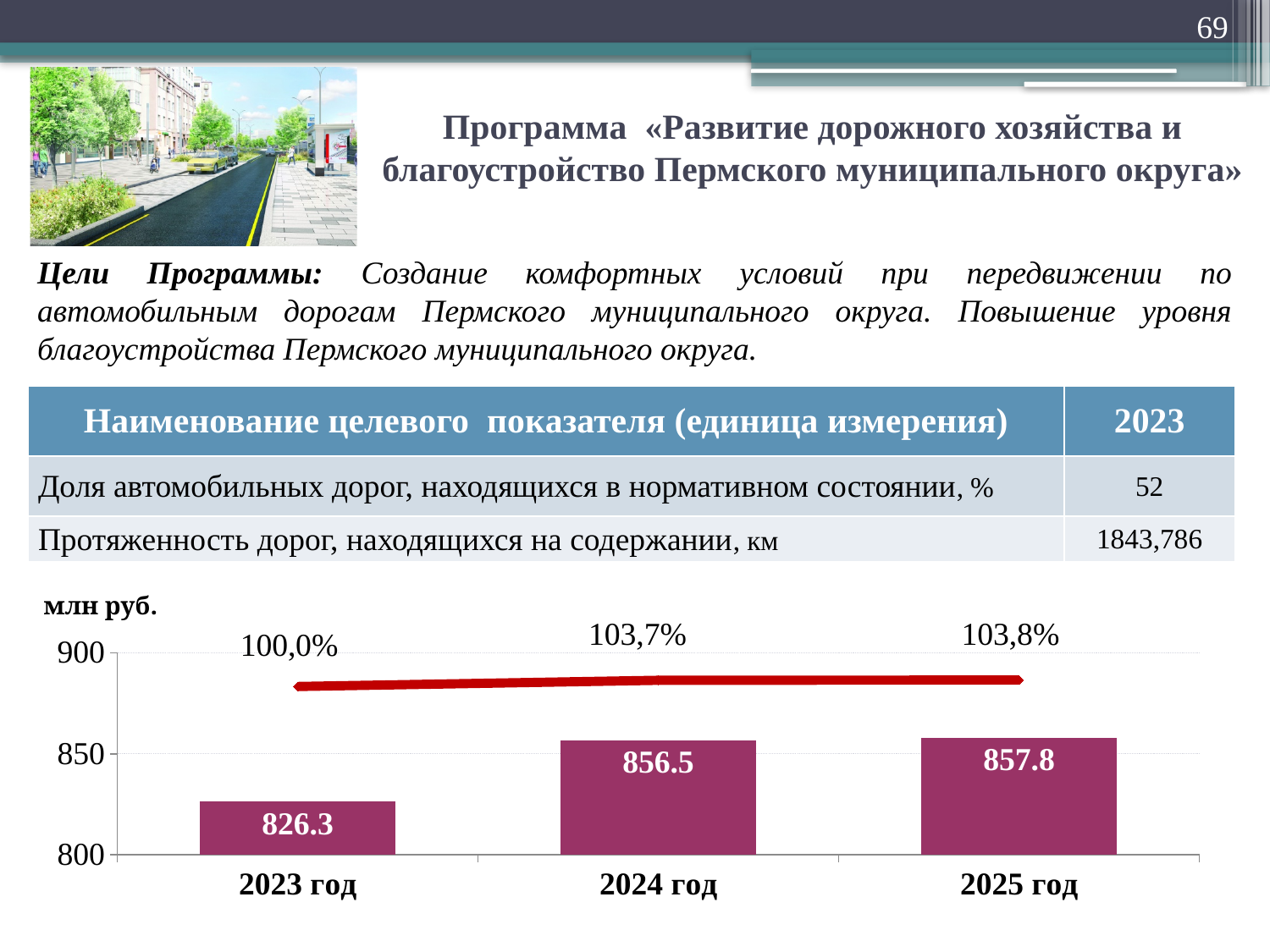
How many years are shown on the x axis of the chart? 3 What kind of chart is shown on the slide? combination bar and line chart What is the difference between the values for 2024 год and 2023 год? 30.2 What percentage label is shown above the 2024 год bar? 103,7% What is the difference between the values for 2025 год and 2024 год? 1.3 What is the value for 2023 год in the bar chart? 826.3 What is the value for 2025 год in the bar chart? 857.8 Which is larger, the value for 2023 год or the value for 2024 год? 2024 год Which year has the lowest bar in the chart? 2023 год Which year has the highest bar in the chart? 2025 год Is the value for 2023 год greater or less than 850? less What is the value for 2024 год in the bar chart? 856.5